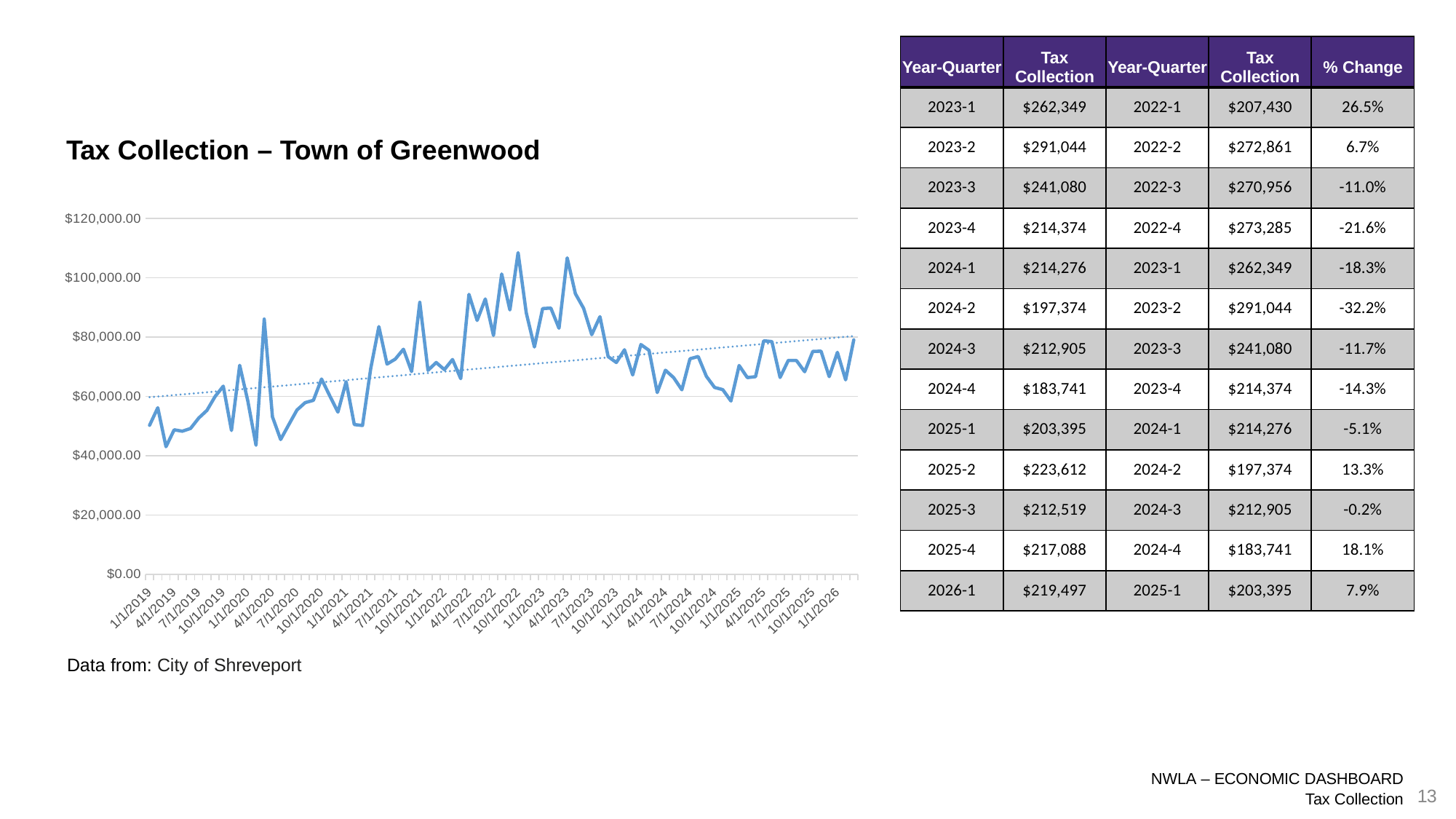
What is the highest value shown on the y axis? $120,000.00 Is the value for 4/1/2020 greater or less than $60,000.00? less Does the dotted trend line rise or fall from left to right? rise What is the title of the chart? Tax Collection – Town of Greenwood Is the value for 1/1/2019 greater or less than $60,000.00? less Is the value for 10/1/2022 greater or less than $80,000.00? greater Which is larger, the value for 10/1/2022 or the value for 1/1/2019? 10/1/2022 In which year does the line reach its highest point? 2022 What kind of chart is shown on the slide? line chart